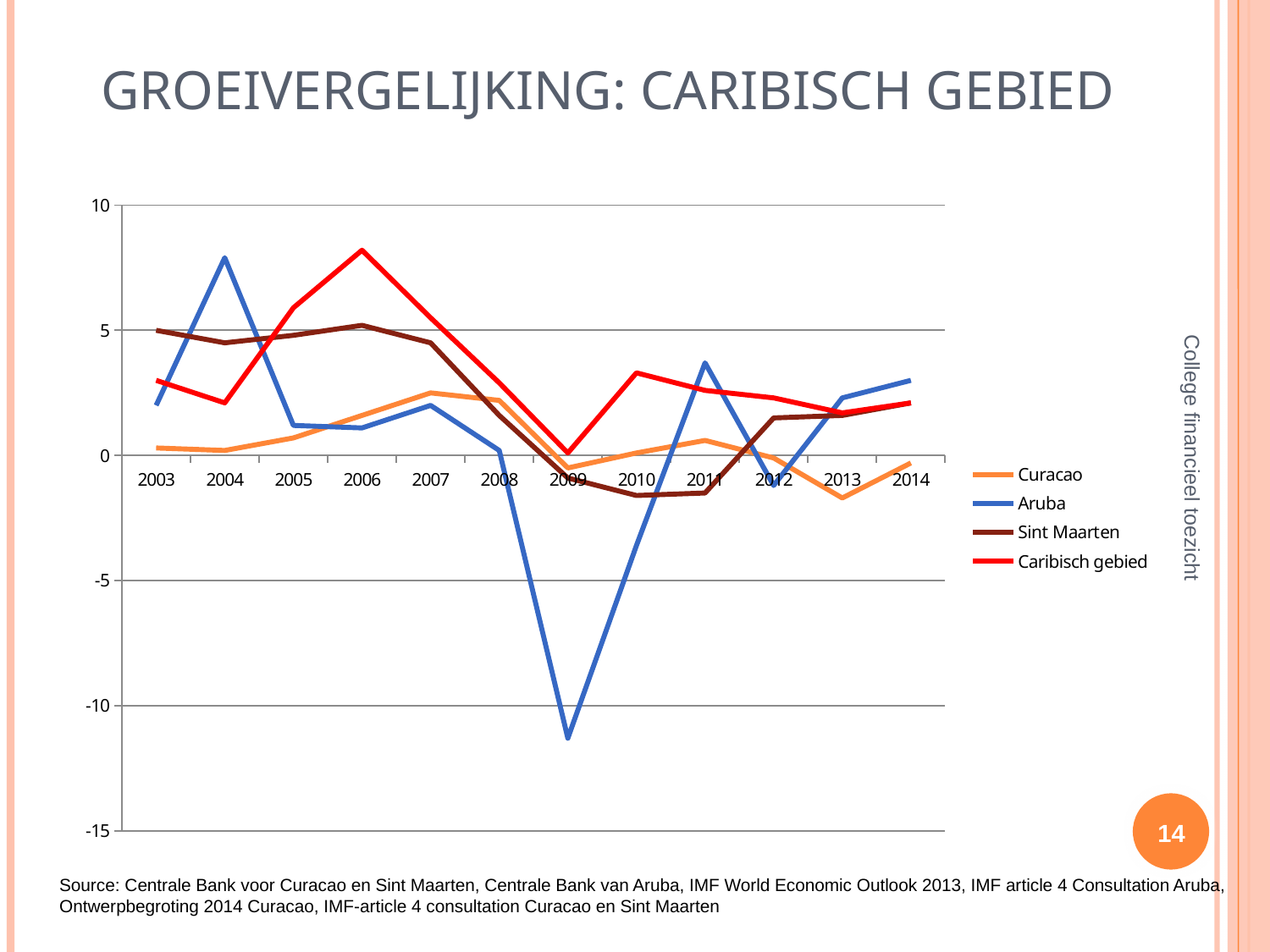
How many series does the legend list? 4 How many years are plotted along the x axis? 12 Which is larger in 2004, the value for Aruba or the value for Curacao? Aruba In which year does the Aruba line reach its highest value? 2004 Is the value for Aruba in 2009 greater or less than -10? less Is the value for Curacao in 2013 greater or less than 0? less Does the Caribisch gebied line rise or fall from 2006 to 2009? fall In which year does the Caribisch gebied line reach its highest value? 2006 Which series is drawn in red? Caribisch gebied Is the value for Caribisch gebied in 2006 greater or less than 5? greater In which year does the Aruba line reach its lowest value? 2009 What kind of chart is shown on the slide? line chart